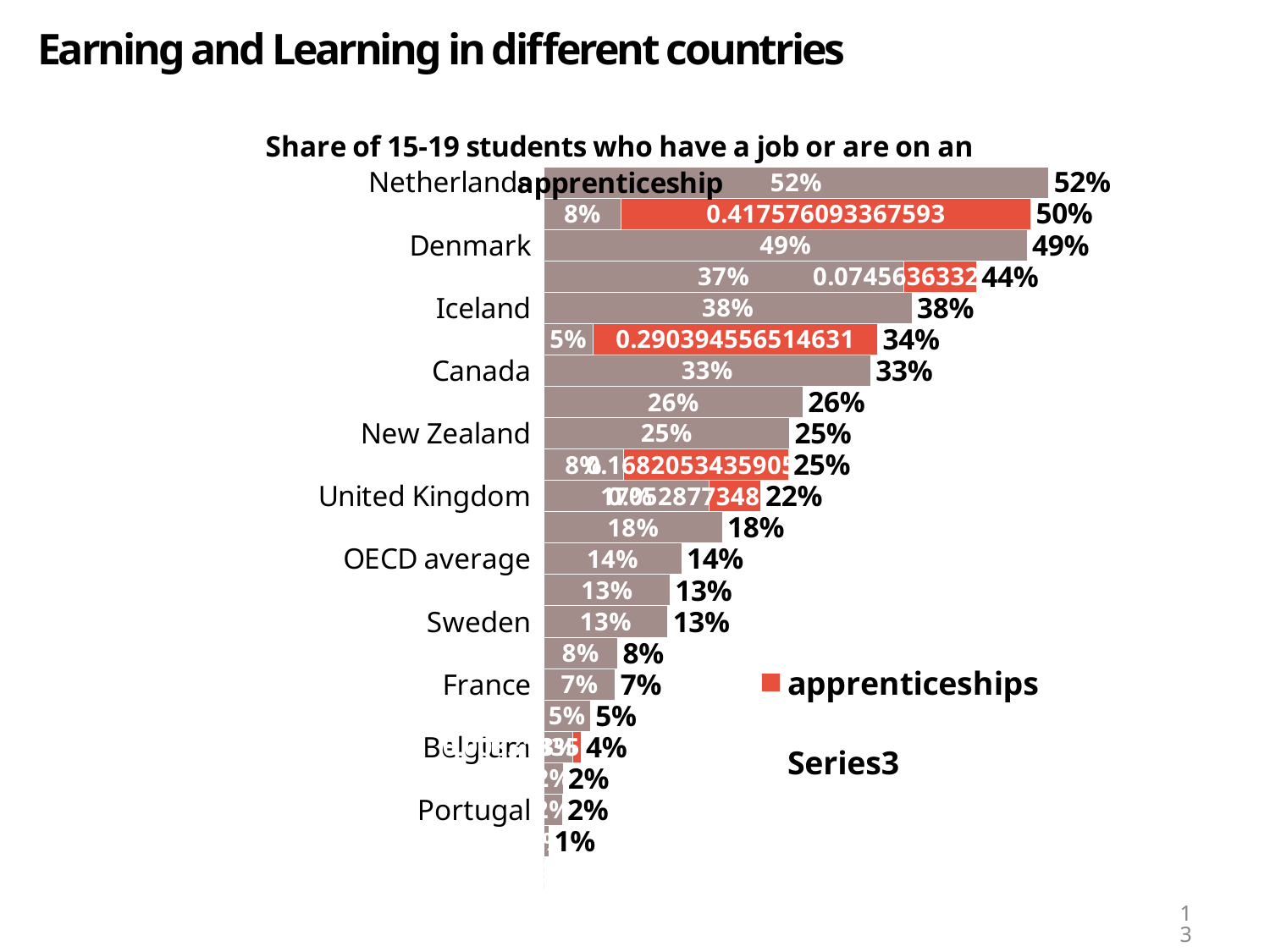
What is the total value shown for the Netherlands? 52% What is the total value shown for Canada? 33% What is the total value shown for France? 7% What is the total value shown for the United Kingdom? 22% What is the total value shown for Denmark? 49% What is the total value shown for the OECD average? 14% Which has a larger total value, Iceland or Canada? Iceland What is the difference between the total values for the Netherlands and Denmark? 3 percentage points What kind of chart is shown on the slide? Bar chart What is the title of the chart? Share of 15-19 students who have a job or are on an apprenticeship Which labelled country has the highest total value? Netherlands What is the total value shown for Iceland? 38%